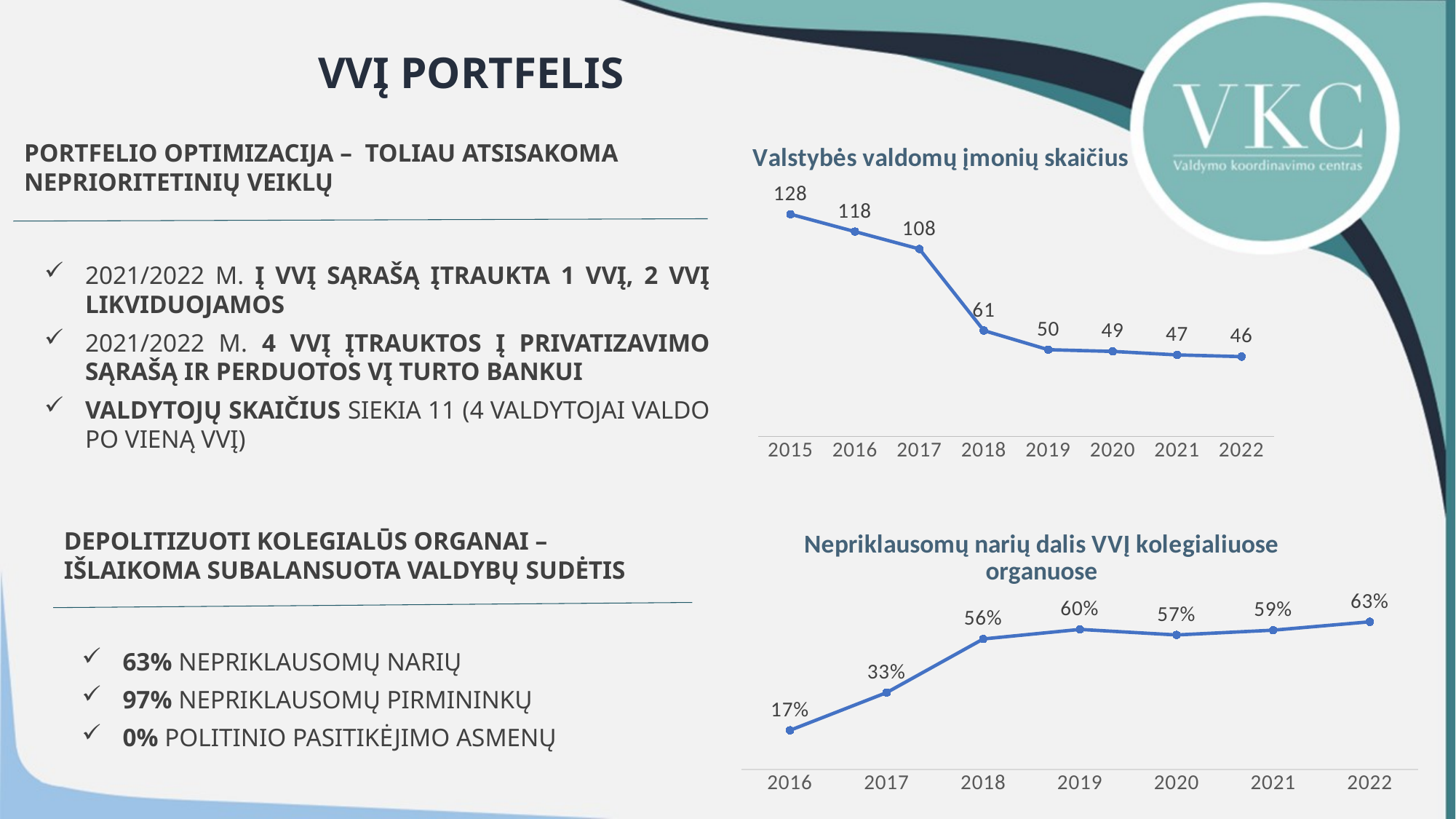
In the chart titled 'Valstybės valdomų įmonių skaičius', what is the difference between the values for 2017 and 2018? 47 In the chart titled 'Nepriklausomų narių dalis VVĮ kolegialiuose organuose', how many years are plotted? 7 What kind of chart is 'Valstybės valdomų įmonių skaičius'? line chart In the chart titled 'Valstybės valdomų įmonių skaičius', how many years are plotted? 8 In the chart titled 'Nepriklausomų narių dalis VVĮ kolegialiuose organuose', which year has the highest value? 2022 In the chart titled 'Nepriklausomų narių dalis VVĮ kolegialiuose organuose', what is the value for 2016? 17% In the chart titled 'Nepriklausomų narių dalis VVĮ kolegialiuose organuose', what is the difference between the values for 2017 and 2018? 23% In the chart titled 'Valstybės valdomų įmonių skaičius', do the values rise or fall from 2015 to 2022? fall In the chart titled 'Nepriklausomų narių dalis VVĮ kolegialiuose organuose', which is larger, the value for 2019 or the value for 2020? 2019 In the chart titled 'Valstybės valdomų įmonių skaičius', which year has the lowest value? 2022 In the chart titled 'Valstybės valdomų įmonių skaičius', what is the value for 2015? 128 In the chart titled 'Valstybės valdomų įmonių skaičius', what is the value for 2018? 61